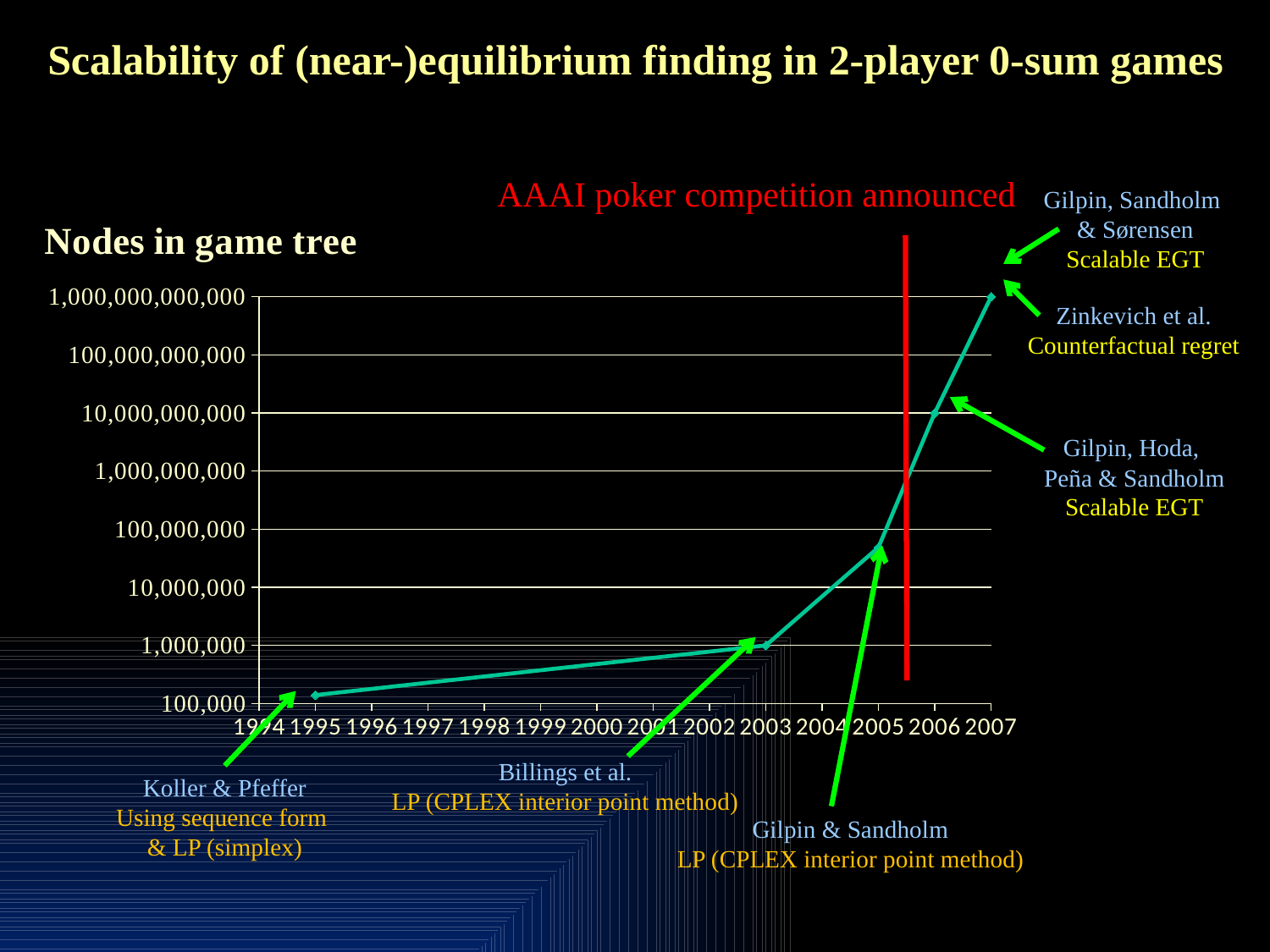
What quantity does the y axis of the chart represent? Nodes in game tree Is the value for 2005 greater or less than 10,000,000? greater What is the title of the slide's chart? Nodes in game tree Which is larger, the value for 2003 or the value for 2006? 2006 What kind of chart is shown on the slide? line chart Is the value for 1995 greater or less than 1,000,000? less Is the value for 2005 greater or less than 100,000,000? less Which year has the highest number of nodes in the game tree on the chart? 2007 Do the values on the chart rise or fall from 1994 to 2007? rise Which year has the lowest number of nodes in the game tree on the chart? 1995